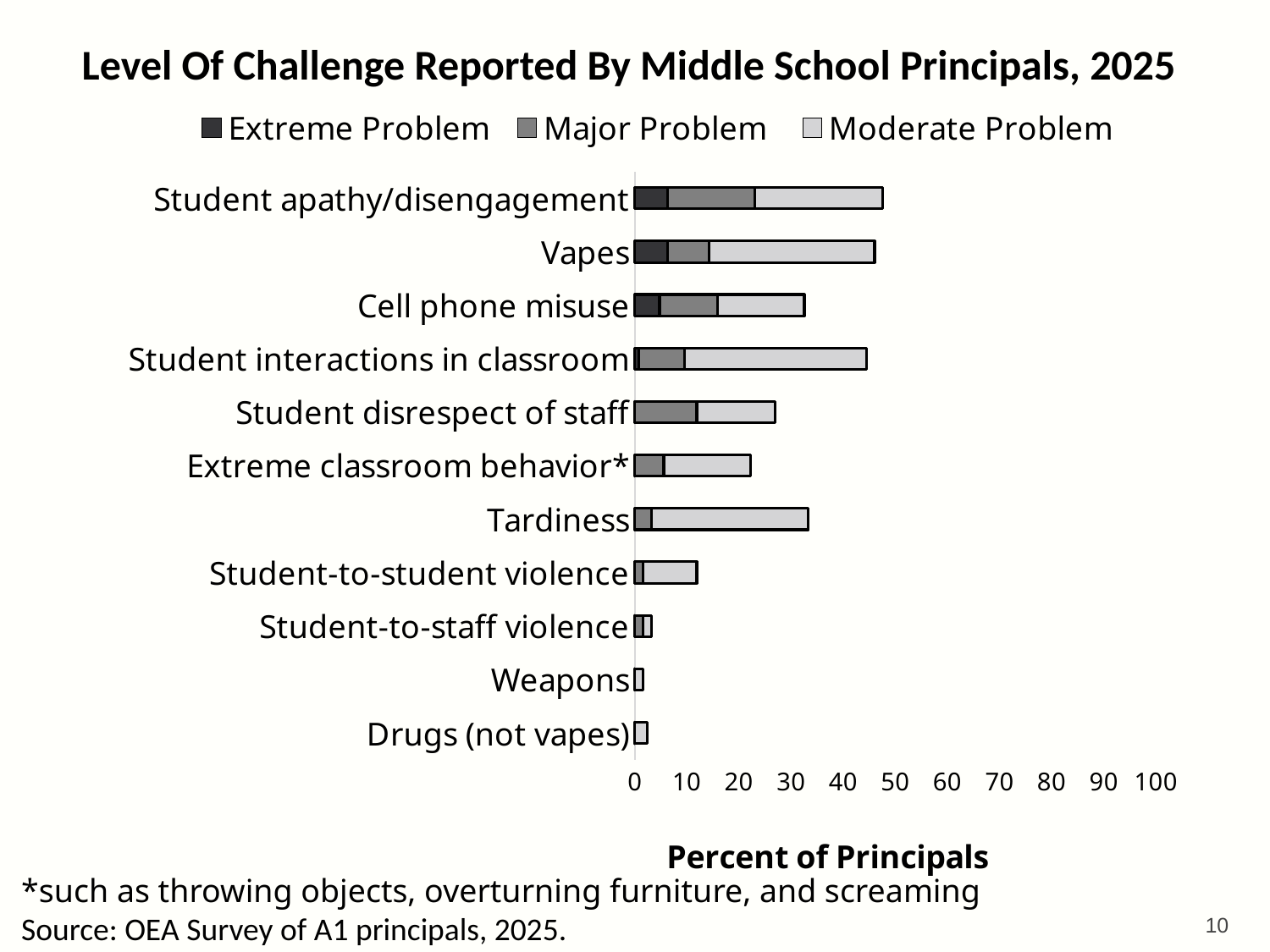
Which has the longer total bar, Tardiness or Student-to-student violence? Tardiness What is the label on the horizontal axis? Percent of Principals Is the total bar length for Student disrespect of staff greater or less than 30? less Is the total bar length for Student-to-staff violence greater or less than 10? less Is the total bar length for Extreme classroom behavior* greater or less than 30? less Which has the longer total bar, Student apathy/disengagement or Cell phone misuse? Student apathy/disengagement What are the three series named in the legend? Extreme Problem, Major Problem, Moderate Problem How many series does the legend list? 3 What kind of chart is shown on the slide? Stacked bar chart How many categories (challenges) are listed on the chart? 11